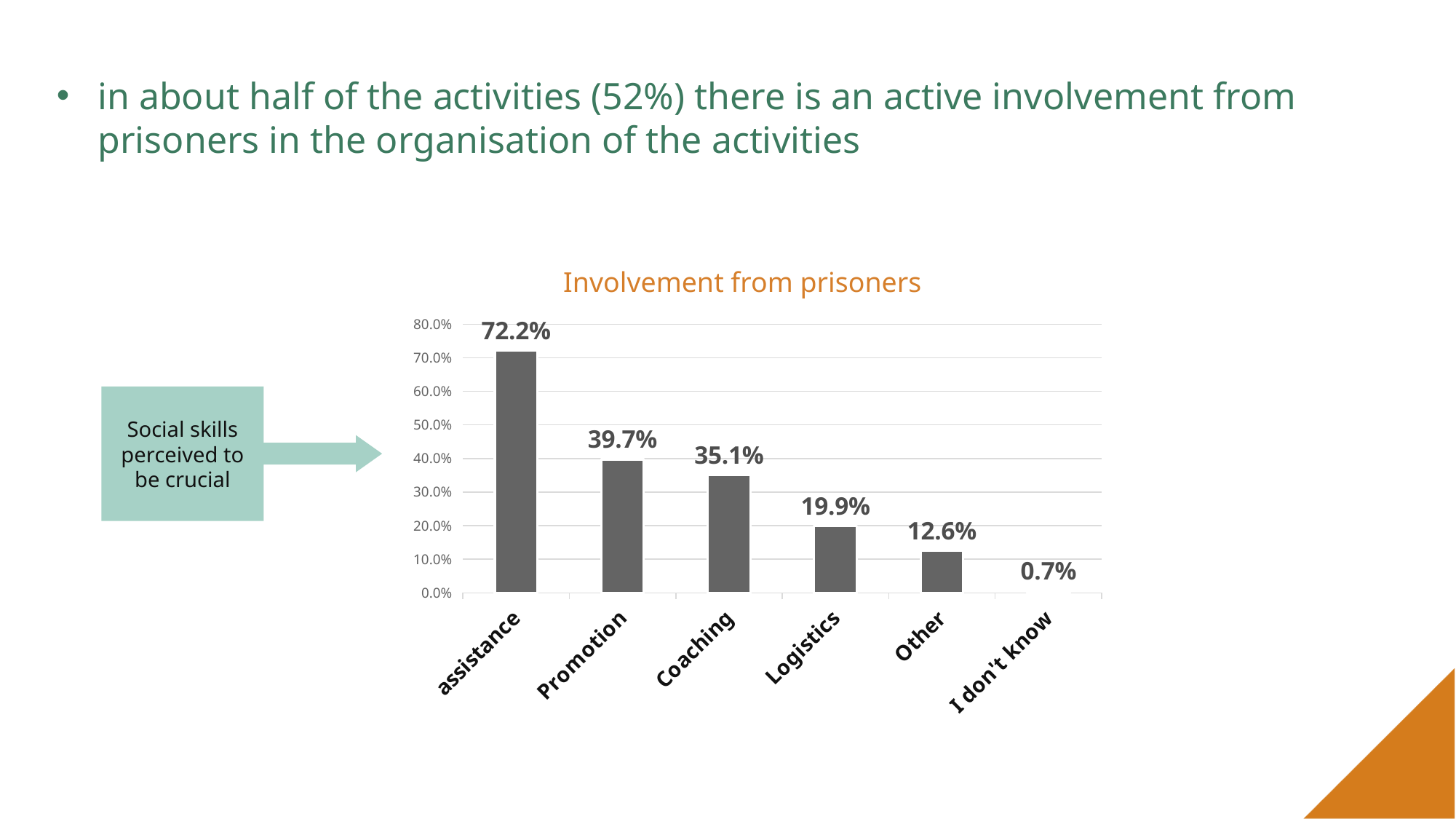
What is the value for Logistics? 19.9% Which is larger, the value for Logistics or the value for Other? Logistics What is the value for I don't know? 0.7% Which category has the highest value? assistance What is the value for Coaching? 35.1% What kind of chart is shown? bar chart What is the value for assistance? 72.2% What is the title of the chart? Involvement from prisoners What is the difference between the values for assistance and Promotion? 32.5% What is the value for Promotion? 39.7% How many categories are shown on the x axis? 6 Which category has the lowest value? I don't know